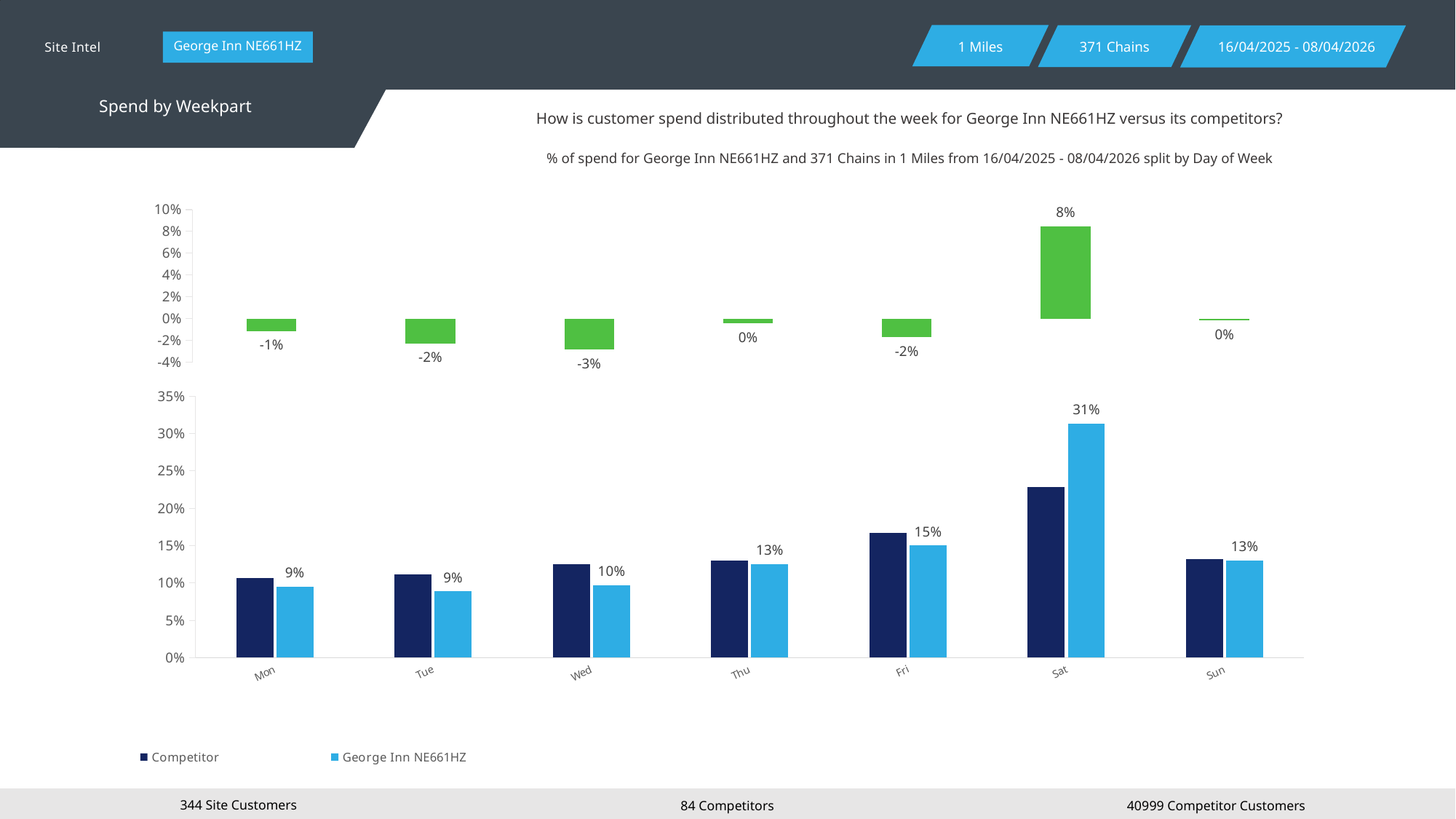
How many days of the week are shown on the x axis of the bottom chart? 7 In the bottom chart, is the Competitor value for Mon greater or less than 15%? less In the bottom chart, what is the value for George Inn NE661HZ on Sat? 31% In the bottom chart, on Sat, which is larger: the Competitor value or the George Inn NE661HZ value? George Inn NE661HZ In the bottom chart, what is the difference between the George Inn NE661HZ values for Sat and Fri? 16% In the top chart, what is the value for Sat? 8% In the top chart, which day has the lowest value? Wed What kind of chart is the bottom chart? bar chart In the bottom chart, what is the value for George Inn NE661HZ on Fri? 15% How many series does the legend of the bottom chart list? 2 In the bottom chart, on which day is the George Inn NE661HZ value highest? Sat In the bottom chart, is the Competitor value for Sat greater or less than 20%? greater